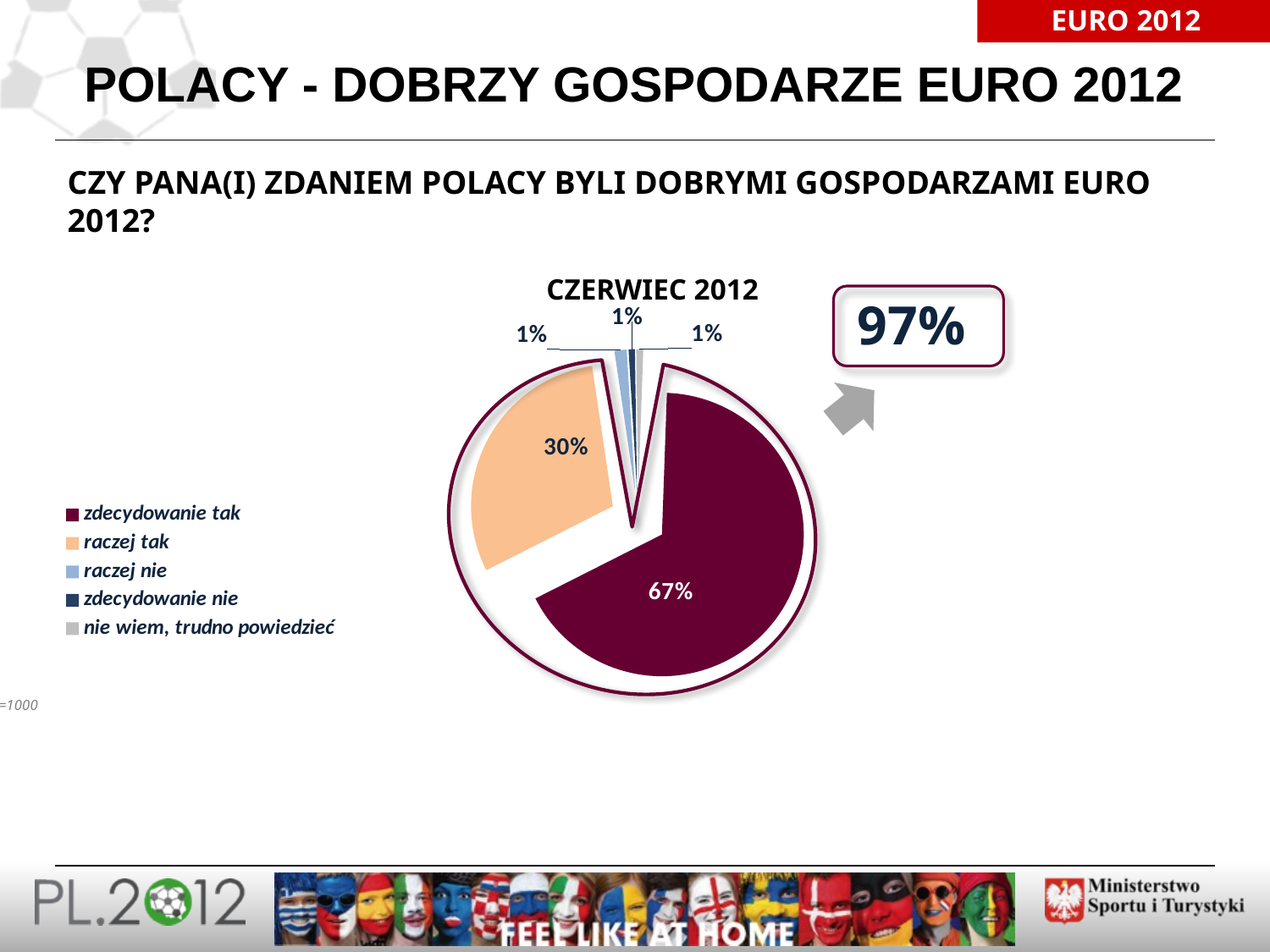
What is the difference in percentage points between "zdecydowanie tak" and "raczej tak"? 37 What value is shown in the highlighted box next to the pie chart? 97% Which answer category has the largest share of the pie? zdecydowanie tak What percentage of respondents answered "raczej tak"? 30% How many slices of the pie are labelled 1%? 3 How many categories does the legend list? 5 What percentage of respondents answered "zdecydowanie tak"? 67% What is the combined share of "zdecydowanie tak" and "raczej tak"? 97% Which is larger, the share for "zdecydowanie tak" or the share for "raczej tak"? zdecydowanie tak What is the title of the pie chart? CZERWIEC 2012 What kind of chart is shown on the slide? pie chart Which legend entry is shown in the light orange colour? raczej tak